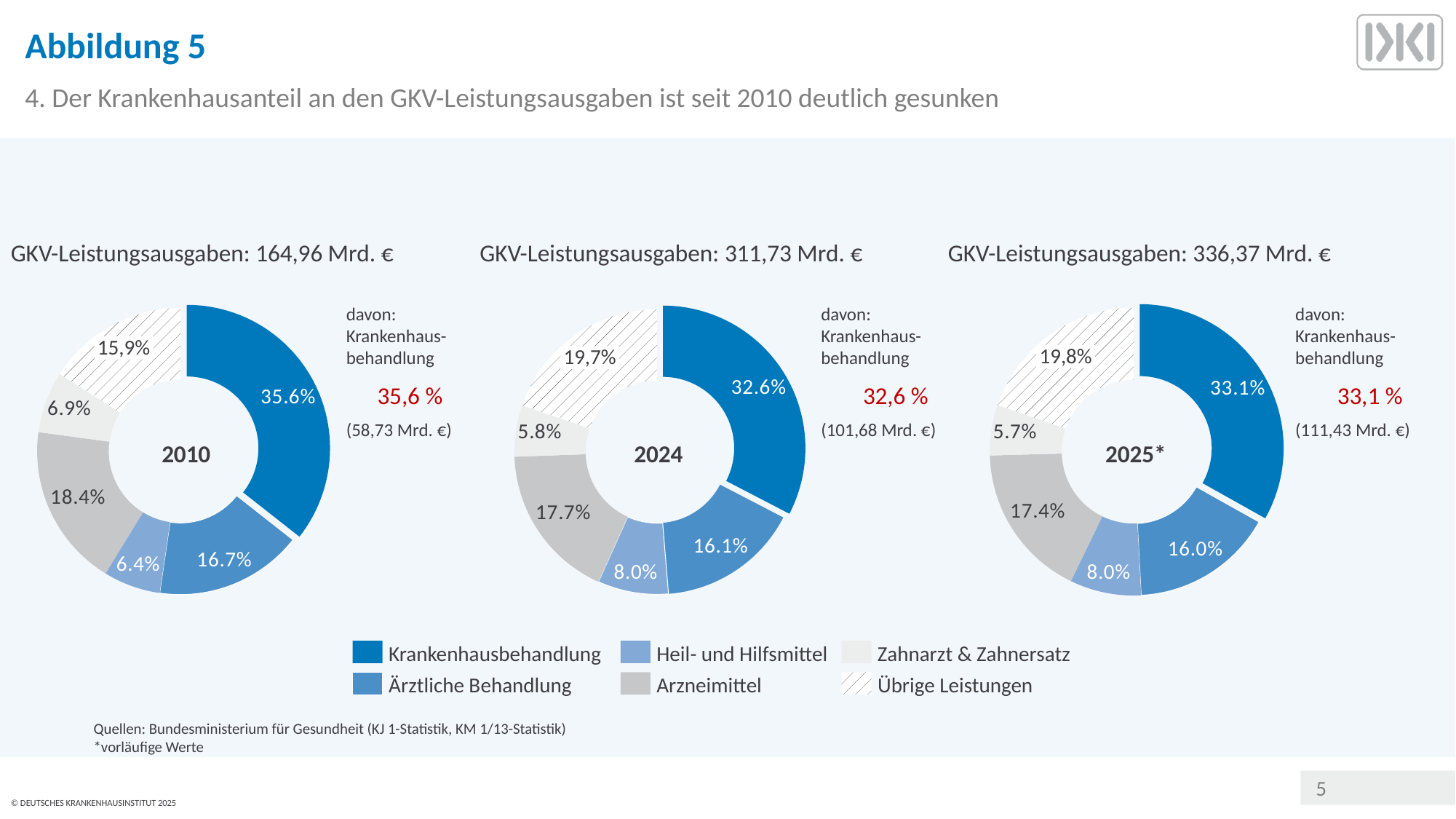
In the 2024 chart, which category has the smallest share? Zahnarzt & Zahnersatz In the 2025* chart, what share is shown for Heil- und Hilfsmittel? 8.0% In the 2010 chart, what share is shown for Krankenhausbehandlung? 35.6% What kind of chart is used for the 2024 data? Donut (pie) chart In the 2025* chart, what share is shown for Übrige Leistungen? 19,8% In the 2010 chart, which category has the largest share? Krankenhausbehandlung How many categories does the legend list? 6 In the 2010 chart, which is larger: the share for Arzneimittel or the share for Ärztliche Behandlung? Arzneimittel How many slices does each donut chart have? 6 What total GKV-Leistungsausgaben value is shown above the 2025* chart? 336,37 Mrd. € What is the difference between the Krankenhausbehandlung share in the 2010 chart and in the 2024 chart? 3.0 percentage points In the 2024 chart, what share is shown for Arzneimittel? 17.7%